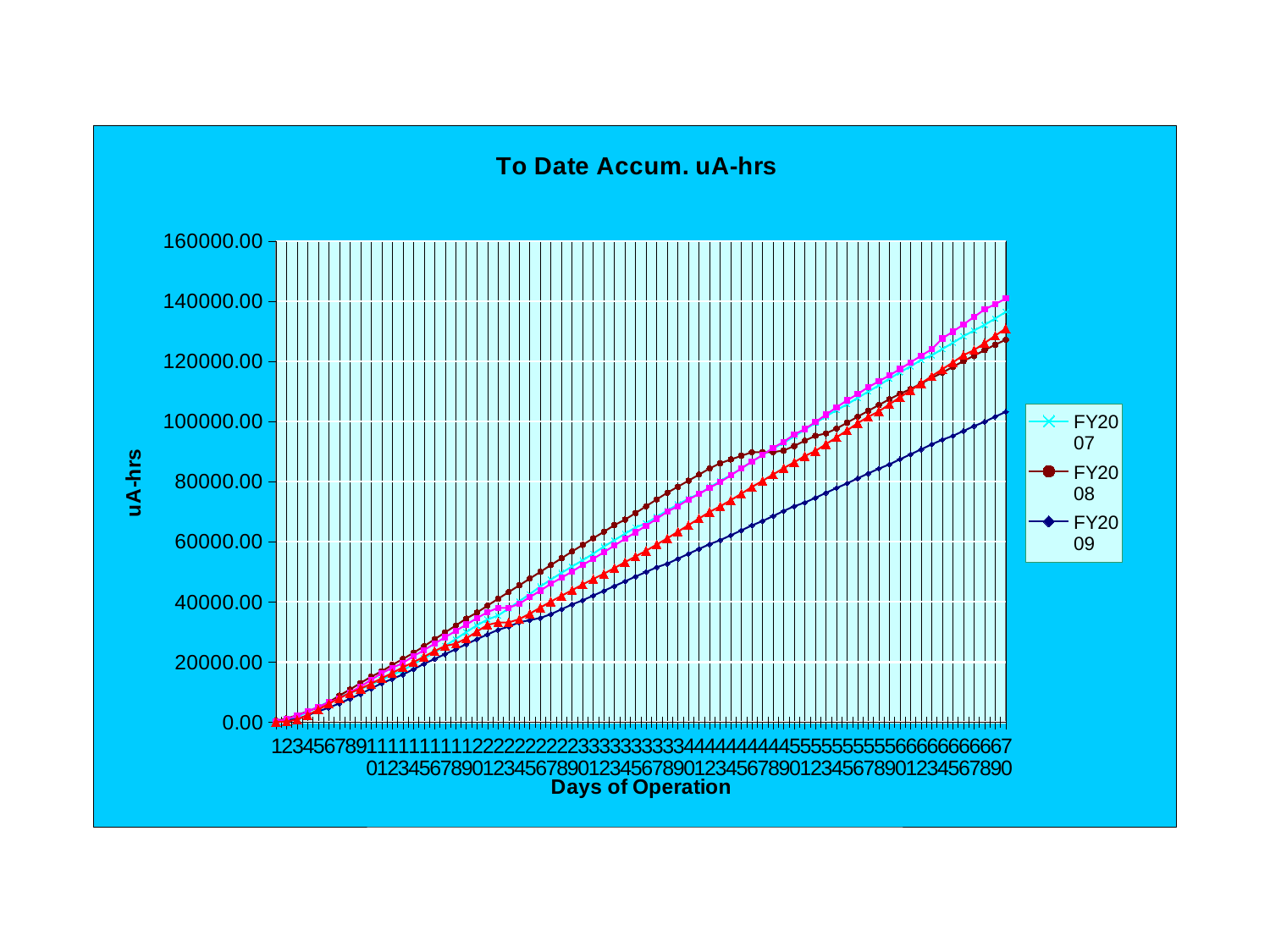
What is the label of the x axis? Days of Operation What is the title of the chart? To Date Accum. uA-hrs Do the accumulated uA-hrs values rise or fall as the days of operation increase? rise How many series does the legend list? 3 At day 70, which is larger, the FY2008 value or the FY2009 value? FY2008 Is the FY2009 value at day 70 greater or less than 120000.00? less At day 70, which is larger, the FY2007 value or the FY2009 value? FY2007 How many days of operation are shown on the x axis? 70 Is the FY2007 value at day 70 greater or less than 140000.00? less Of the series listed in the legend, which has the lowest value at day 70? FY2009 What kind of chart is shown on the slide? line chart Is the FY2008 value at day 70 greater or less than 120000.00? greater